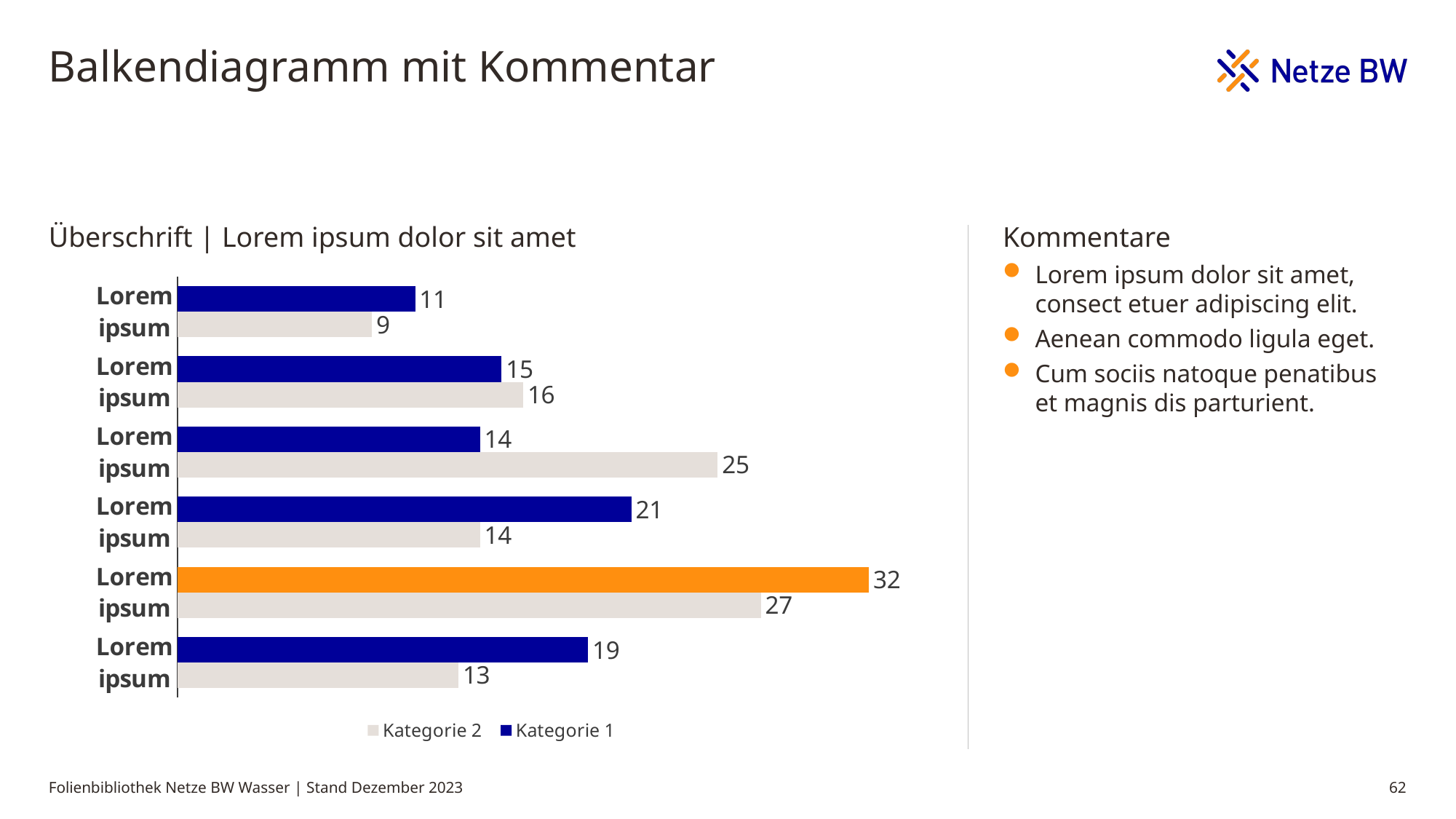
How many categories are plotted on the chart? 6 What is the lowest Kategorie 2 value shown in the chart? 9 What is the Kategorie 1 value for the topmost category? 11 What is the difference between the Kategorie 1 value (21) and the Kategorie 2 value (14) in the fourth category from the top? 7 Which legend entry is shown in grey? Kategorie 2 What is the value of the orange highlighted bar? 32 How many series does the chart legend list? 2 What is the Kategorie 2 value for the bottom category? 13 In the fifth category from the top, what is the difference between the Kategorie 1 value (32) and the Kategorie 2 value (27)? 5 In the third category from the top, which series has the larger value, Kategorie 1 or Kategorie 2? Kategorie 2 What type of chart is shown on the slide? bar chart Which series has the highest value in the chart, and what is it? Kategorie 1, 32